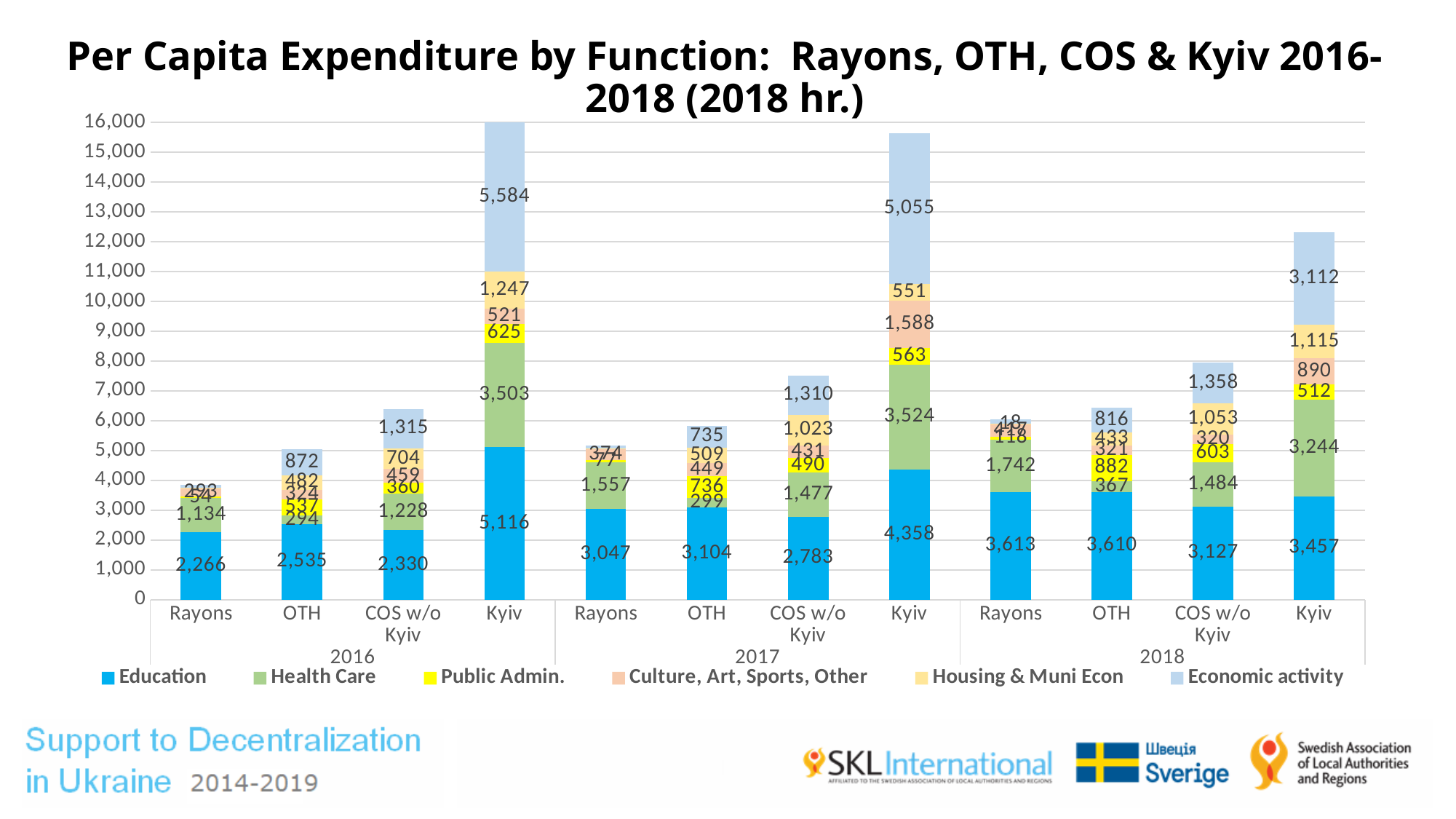
Which bar has the lowest Education value? Rayons 2016 How many series does the legend list? 6 Is the total for the Kyiv 2017 bar greater or less than 15,000? greater Which bar has the highest Education value? Kyiv 2016 What is the Health Care value for Rayons in 2017? 1,557 What type of chart is shown on the slide? Stacked bar chart What is the Economic activity value for Kyiv in 2018? 3,112 How many bars are plotted in the chart? 12 Which is larger, Kyiv's Education value in 2016 or in 2017? 2016 What is the Education value for Kyiv in 2016? 5,116 What is the difference between Kyiv's Economic activity value in 2016 and in 2018? 2,472 Does Kyiv's Economic activity value rise or fall from 2016 to 2018? Fall